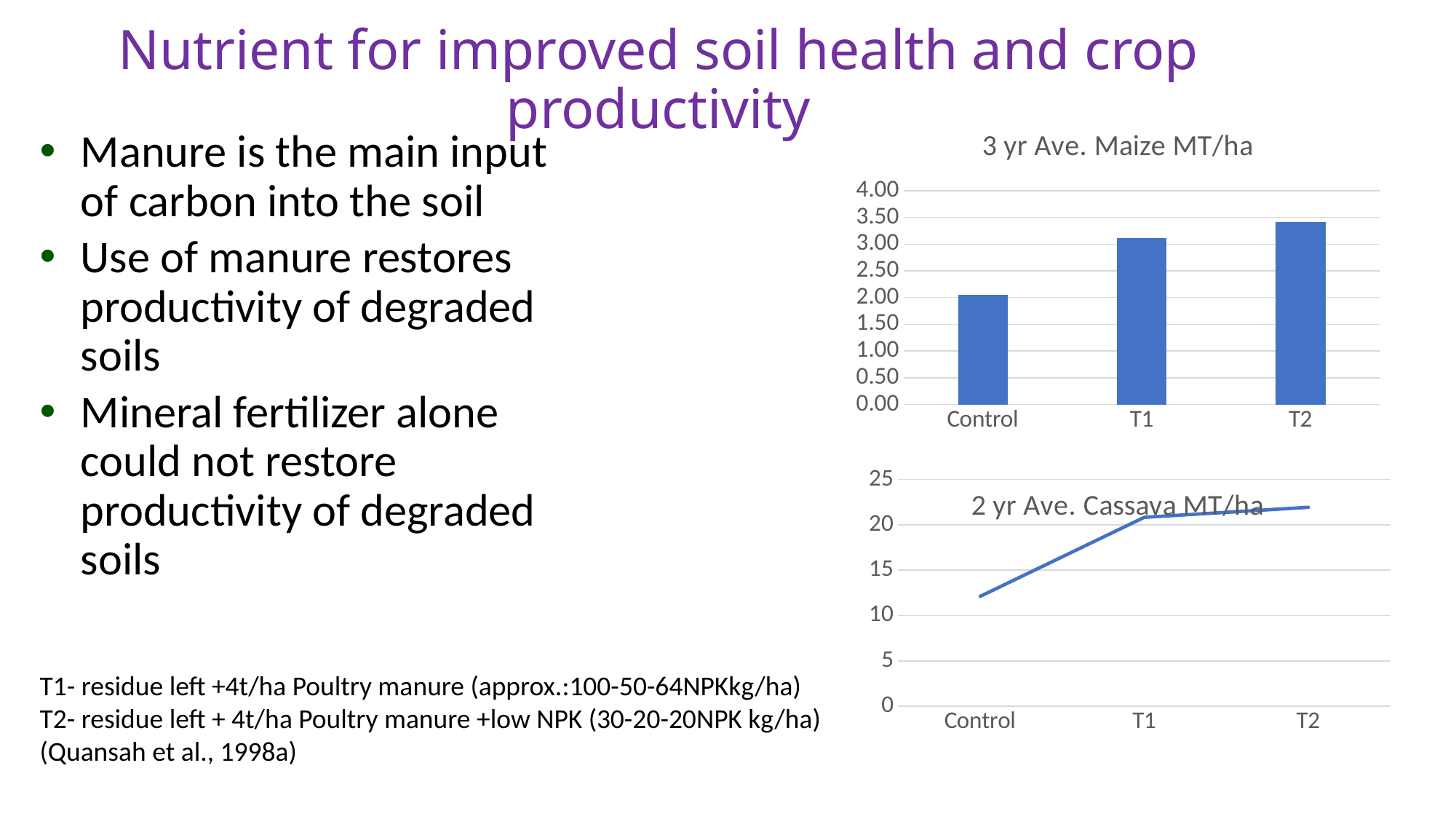
In the '2 yr Ave. Cassava MT/ha' chart, do the values rise or fall from Control to T2? rise In the '2 yr Ave. Cassava MT/ha' chart, is the value for Control greater or less than 15? less In the '3 yr Ave. Maize MT/ha' chart, which category has the highest value? T2 In the '3 yr Ave. Maize MT/ha' chart, how many categories are shown on the x axis? 3 What is the title of the bottom chart on the slide? 2 yr Ave. Cassava MT/ha In the '3 yr Ave. Maize MT/ha' chart, which category has the lowest value? Control In the '3 yr Ave. Maize MT/ha' chart, which is larger, the value for Control or the value for T1? T1 In the '3 yr Ave. Maize MT/ha' chart, is the value for T1 greater or less than 3.00? greater In the '2 yr Ave. Cassava MT/ha' chart, which category has the lowest value? Control What kind of chart is the '3 yr Ave. Maize MT/ha' chart? bar chart What kind of chart is the '2 yr Ave. Cassava MT/ha' chart? line chart In the '3 yr Ave. Maize MT/ha' chart, is the value for Control greater or less than 2.50? less